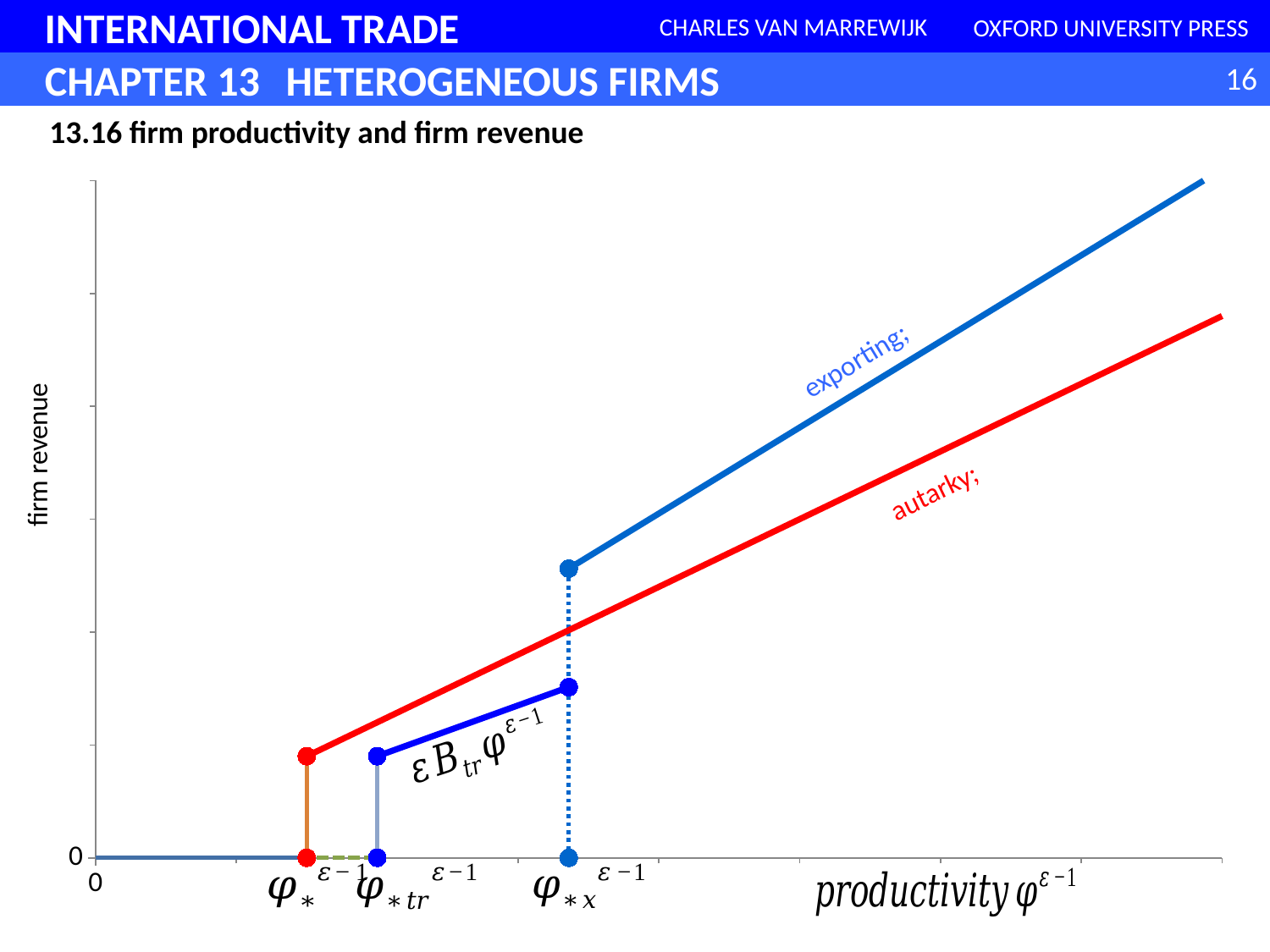
What colour is the line labelled 'autarky;'? red Which marked productivity threshold is the largest? φ*x^(ε−1) Along the autarky line, does firm revenue rise or fall as productivity increases? rises Which marked productivity threshold is the smallest? φ*^(ε−1) Does the exporting line rise or fall as productivity increases? rises How many productivity thresholds are marked on the x axis? 3 Which line is labelled 'exporting;', the blue one or the red one? the blue one What is the title of the chart? 13.16 firm productivity and firm revenue What is firm revenue for productivity levels below the first threshold φ*^(ε−1)? 0 At high productivity levels, which line is higher: exporting or autarky? exporting What kind of chart is shown on the slide? line chart